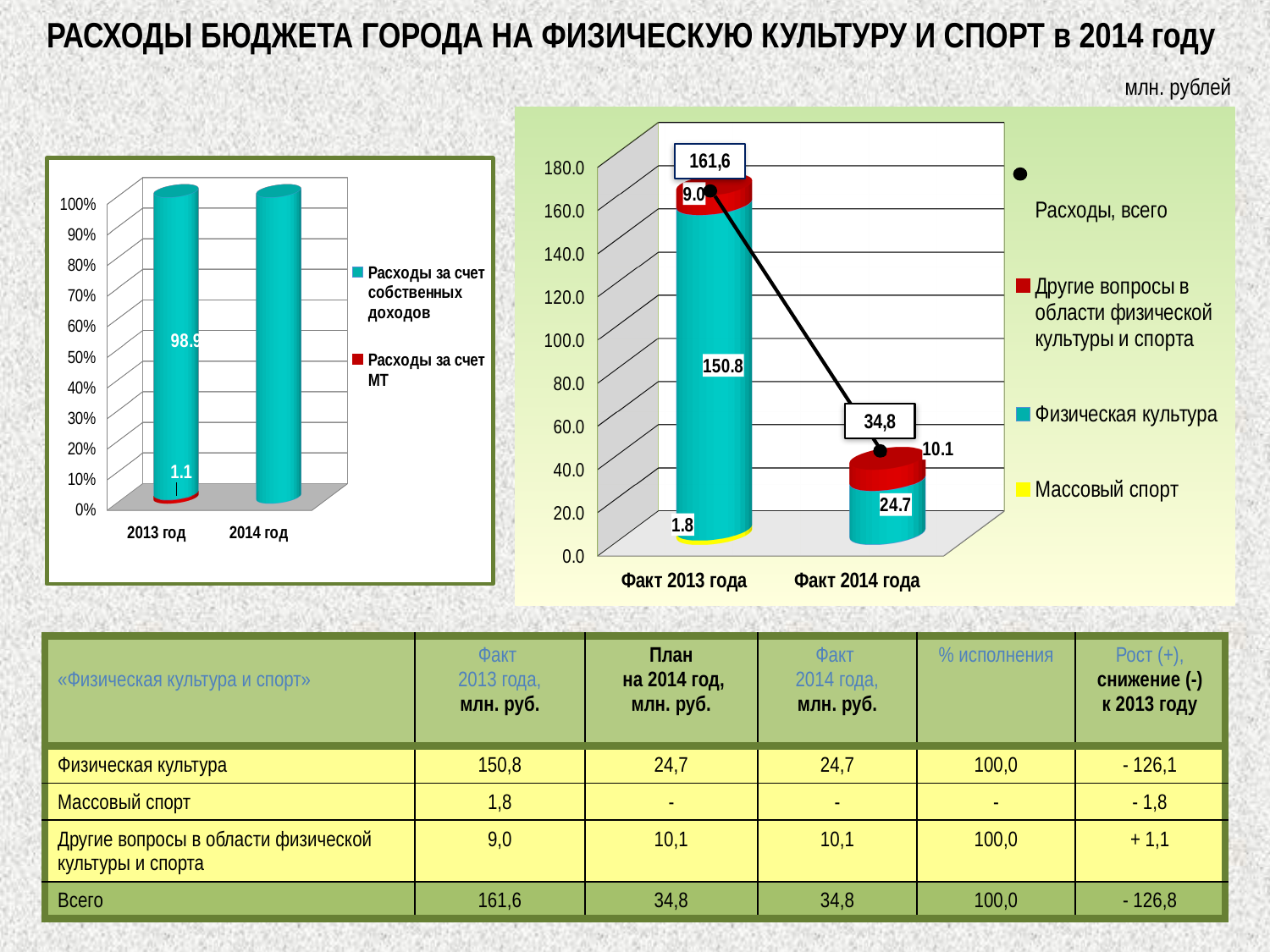
In the right chart, what is the difference between the Физическая культура values for Факт 2013 года and Факт 2014 года? 126.1 In the left chart, what is the value of Расходы за счет собственных доходов for 2013 год? 98.9 In the right chart, what is the value of Массовый спорт for Факт 2013 года? 1.8 In the left chart, what is the value of Расходы за счет МТ for 2013 год? 1.1 In the right chart, what is the value of Физическая культура for Факт 2013 года? 150.8 In the right chart, which category has the higher value for Другие вопросы в области физической культуры и спорта, Факт 2013 года or Факт 2014 года? Факт 2014 года In the right chart, how many entries does the legend list? 4 In the right chart, what total is labelled for Расходы, всего for Факт 2013 года? 161,6 In the right chart, what is the value of Другие вопросы в области физической культуры и спорта for Факт 2014 года? 10.1 In the right chart, what total is labelled for Расходы, всего for Факт 2014 года? 34,8 In the right chart, what is the value of Физическая культура for Факт 2014 года? 24.7 What kind of chart is the left chart? bar chart